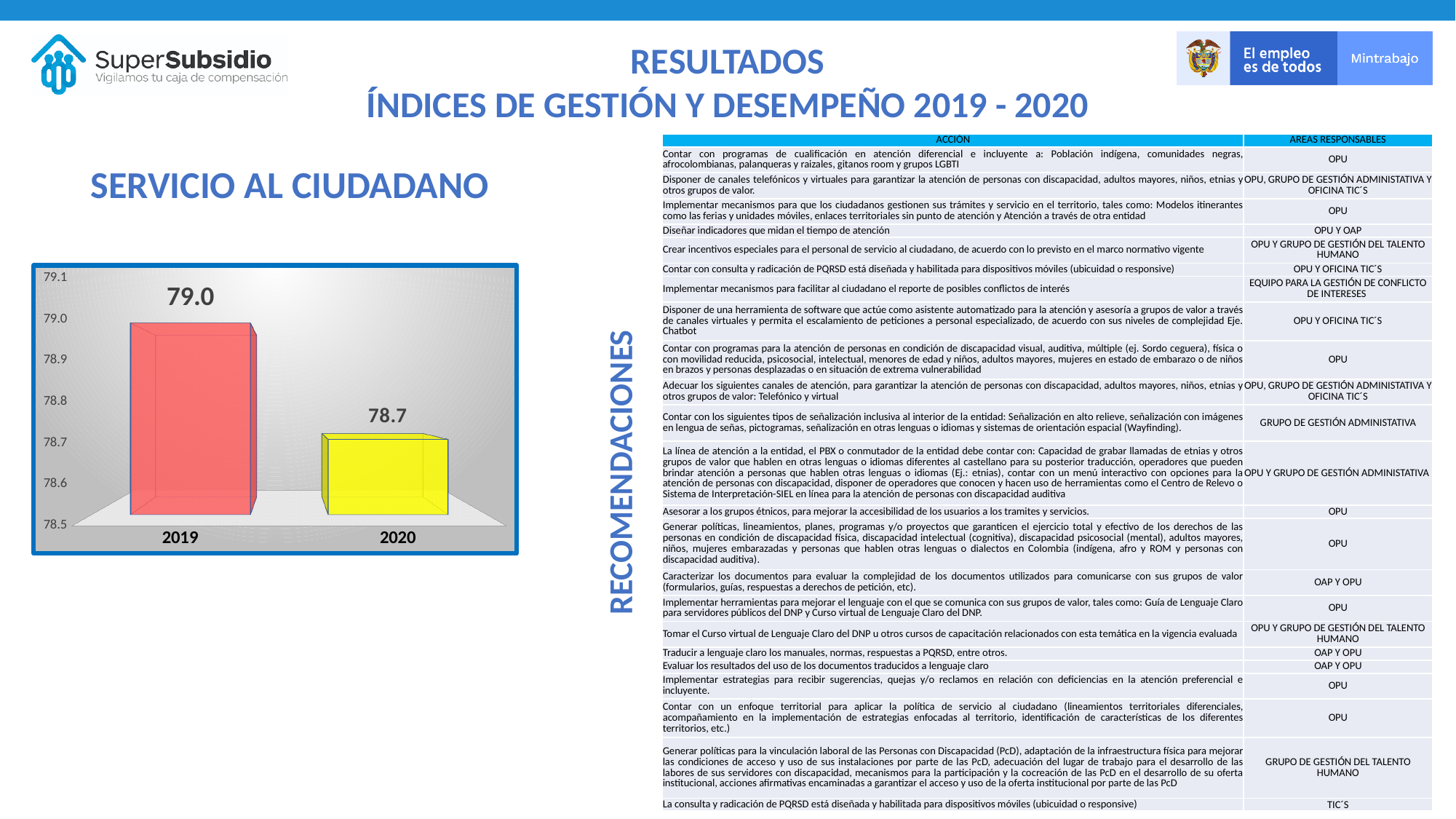
Which year has the highest value in the Servicio al Ciudadano chart? 2019 Do the values in the Servicio al Ciudadano chart rise or fall from 2019 to 2020? fall In the Servicio al Ciudadano chart, is the value for 2019 larger or smaller than the value for 2020? larger What is the value for 2019 in the Servicio al Ciudadano chart? 79.0 What colour is the 2020 bar in the Servicio al Ciudadano chart? yellow How many years (categories) are shown in the Servicio al Ciudadano chart? 2 What kind of chart is used for Servicio al Ciudadano? bar chart Is the value for 2020 in the Servicio al Ciudadano chart greater or less than 79.0? less Which year has the lowest value in the Servicio al Ciudadano chart? 2020 What is the value for 2020 in the Servicio al Ciudadano chart? 78.7 What is the difference between the 2019 and 2020 values in the Servicio al Ciudadano chart? 0.3 Is the value for 2019 in the Servicio al Ciudadano chart greater or less than 78.8? greater